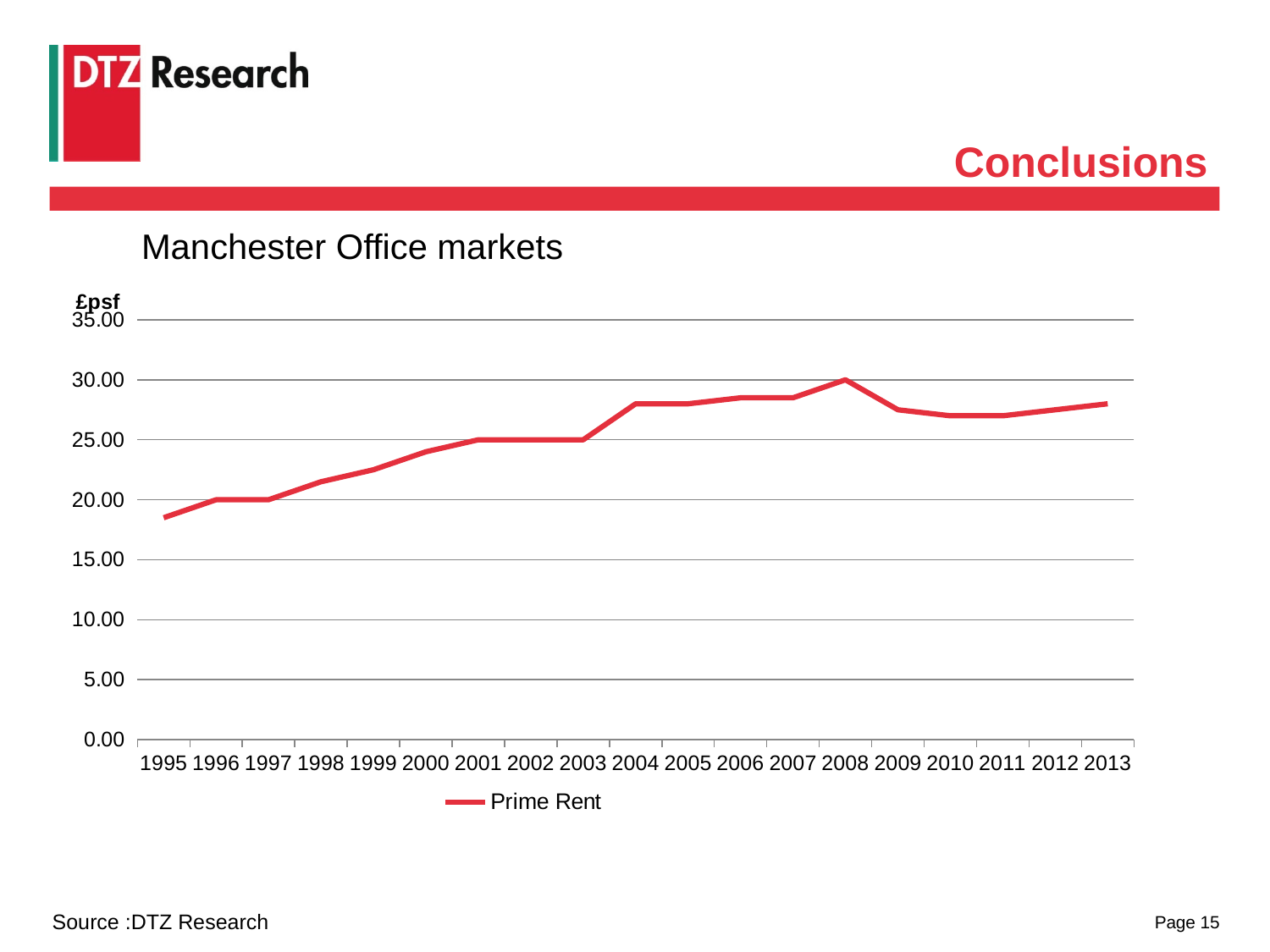
In which year is the Prime Rent highest? 2008 Is the Prime Rent in 1995 greater or less than 20.00? less What is the name of the series shown in the legend? Prime Rent In which year is the Prime Rent lowest? 1995 What kind of chart is shown on the slide? line chart Is the Prime Rent in 2013 greater or less than 25.00? greater What is the Prime Rent in 2002? 25.00 How many series does the legend list? 1 Which year has a higher Prime Rent, 2000 or 2005? 2005 What is the Prime Rent in 2008? 30.00 Does the Prime Rent rise or fall between 1995 and 2008? rise How many years are plotted along the x axis? 19